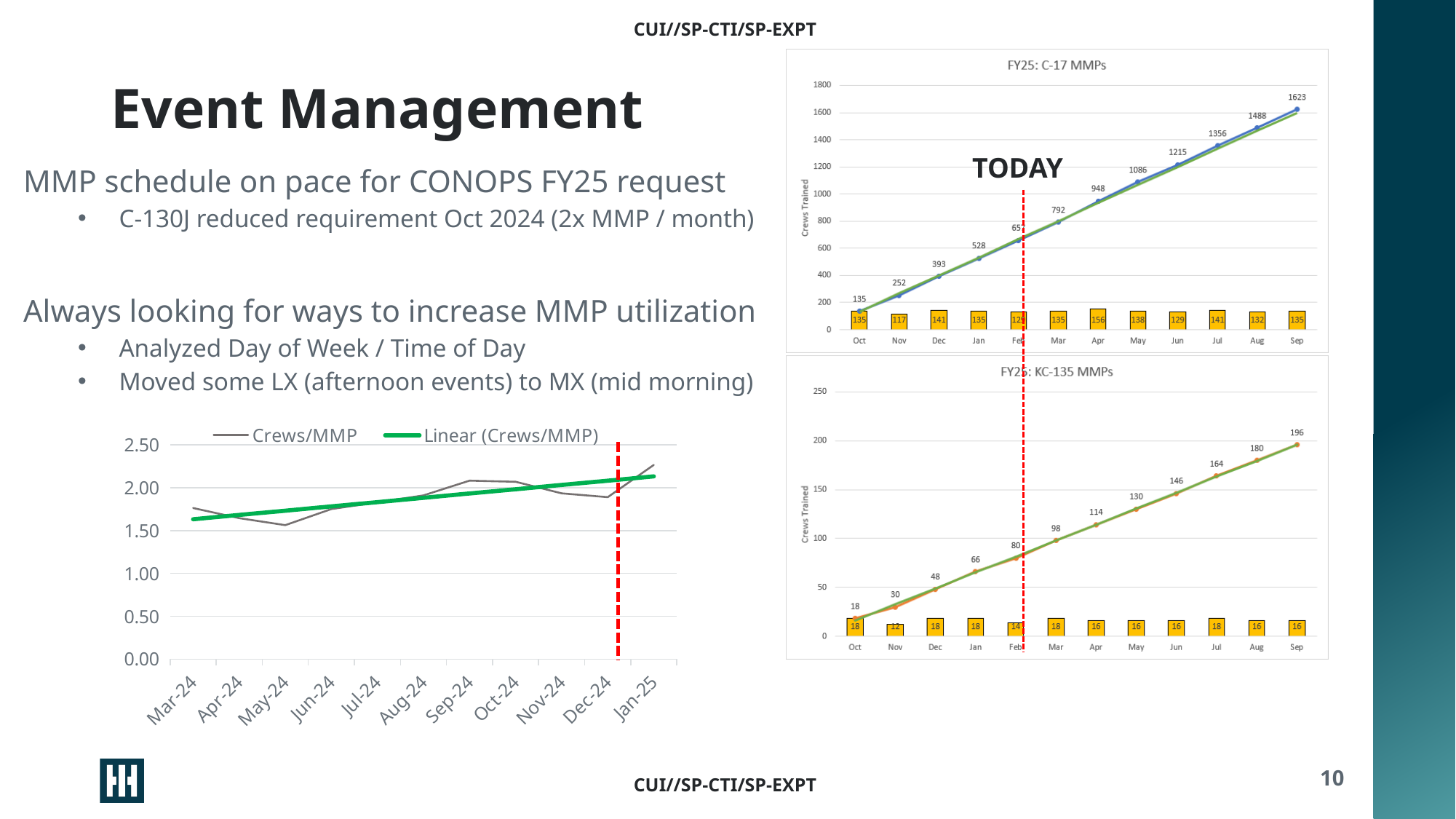
In the FY25: C-17 MMPs chart, what is the cumulative crews trained value labeled at Sep? 1623 In the FY25: C-17 MMPs chart, what is the difference between the cumulative values at Dec and Nov? 141 In the FY25: KC-135 MMPs chart, is the cumulative value at Mar greater or less than 100? less In the Crews/MMP chart at the bottom left, how many series does the legend list? 2 In the FY25: C-17 MMPs chart, which month has the highest monthly bar value? Apr In the FY25: KC-135 MMPs chart, what is the monthly bar value for Nov? 12 In the FY25: C-17 MMPs chart, how many months are shown on the x axis? 12 In the FY25: KC-135 MMPs chart, what is the cumulative crews trained value labeled at Sep? 196 In the Crews/MMP chart at the bottom left, does the Linear (Crews/MMP) trend line rise or fall from Mar-24 to Jan-25? rise In the FY25: KC-135 MMPs chart, what is the difference between the cumulative values at Jul and Jun? 18 In the FY25: C-17 MMPs chart, what is the cumulative crews trained value labeled at Mar? 792 In the FY25: KC-135 MMPs chart, which month has the lowest monthly bar value? Nov